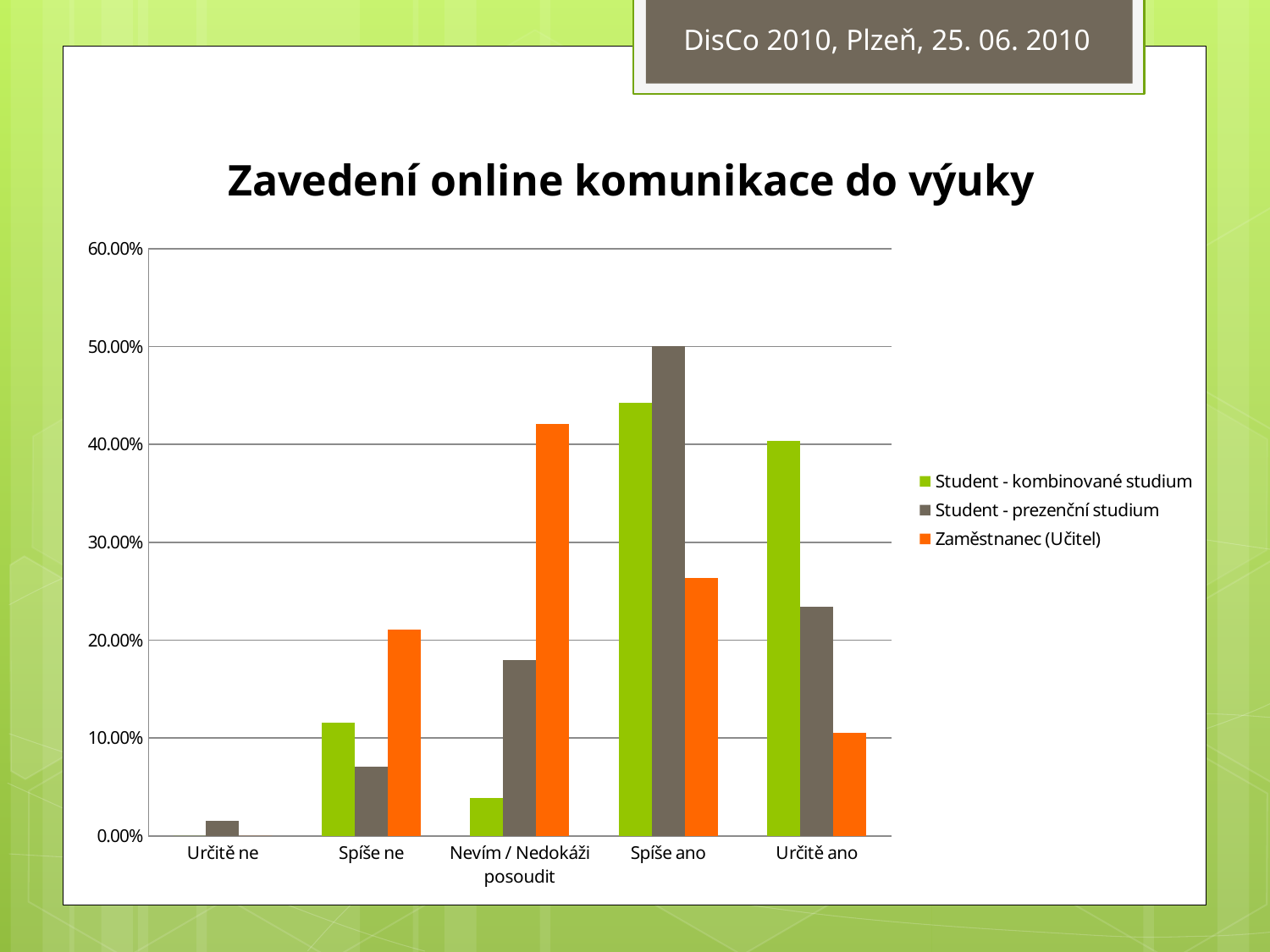
How many categories are shown on the x axis? 5 Is the value for Zaměstnanec (Učitel) in the category Nevím / Nedokáži posoudit greater or less than 40.00%? greater For the series Zaměstnanec (Učitel), which category has the highest value? Nevím / Nedokáži posoudit For the series Student - kombinované studium, which category has the highest value? Spíše ano What kind of chart is shown on the slide? bar chart How many series does the legend list? 3 What is the title of the chart? Zavedení online komunikace do výuky In the category Spíše ano, which is larger: Student - kombinované studium or Student - prezenční studium? Student - prezenční studium For the series Student - prezenční studium, which category has the highest value? Spíše ano Is the value for Student - prezenční studium in the category Určitě ano greater or less than 20.00%? greater Is the value for Zaměstnanec (Učitel) in the category Spíše ano greater or less than 30.00%? less For the series Student - prezenční studium, which category has the lowest value? Určitě ne